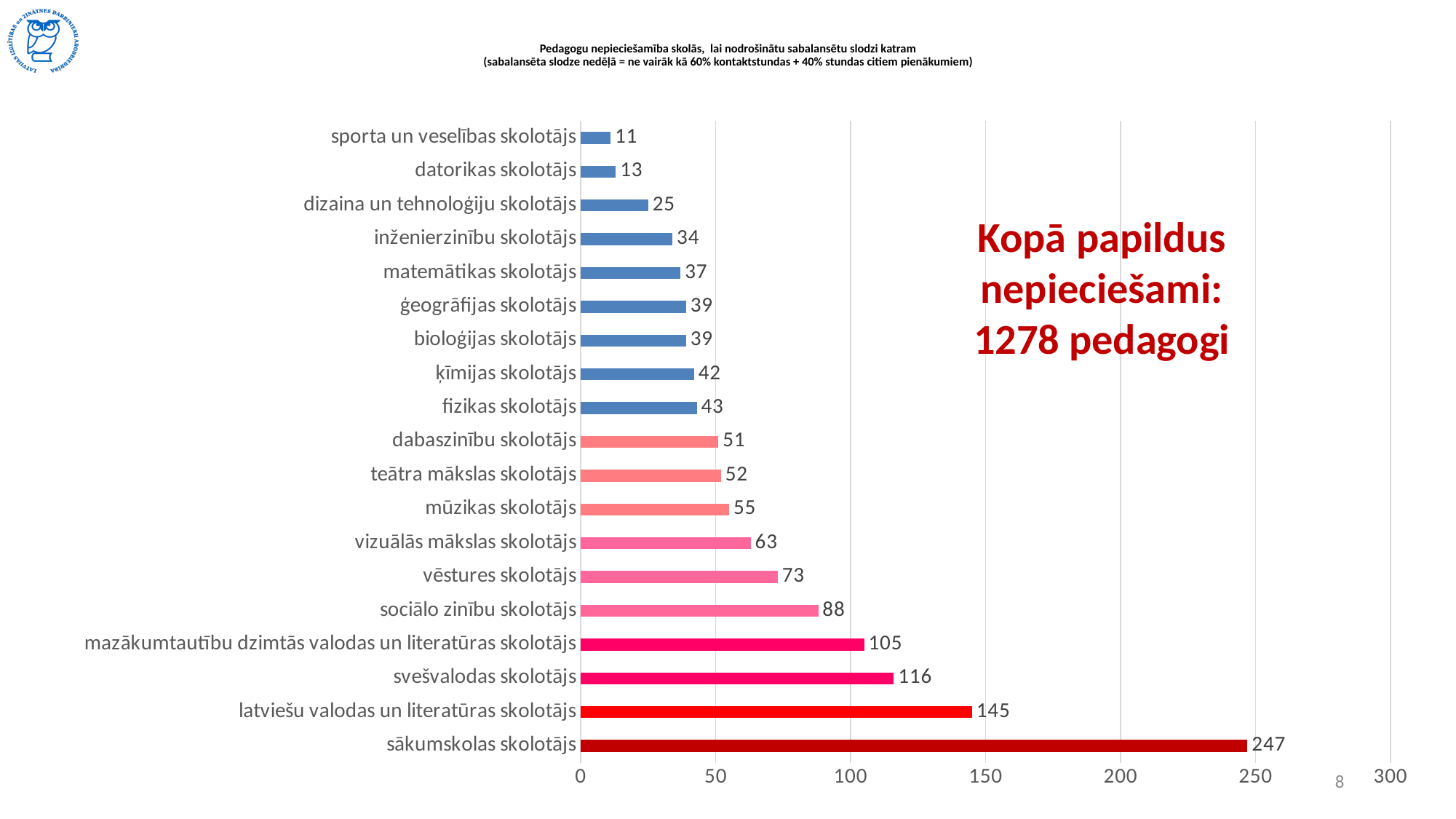
How many categories are shown in the chart? 19 What is the value for matemātikas skolotājs? 37 Which category has the highest value? sākumskolas skolotājs Which is larger, the value for mūzikas skolotājs or the value for vizuālās mākslas skolotājs? vizuālās mākslas skolotājs Is the value for mazākumtautību dzimtās valodas un literatūras skolotājs greater or less than 100? greater What is the difference between the values for sākumskolas skolotājs and latviešu valodas un literatūras skolotājs? 102 What is the value for sākumskolas skolotājs? 247 Which category has the lowest value? sporta un veselības skolotājs What is the value for svešvalodas skolotājs? 116 What is the difference between the values for sociālo zinību skolotājs and vēstures skolotājs? 15 What kind of chart is shown on the slide? bar chart What total number of additional teachers is stated in the red text next to the chart? 1278 pedagogi